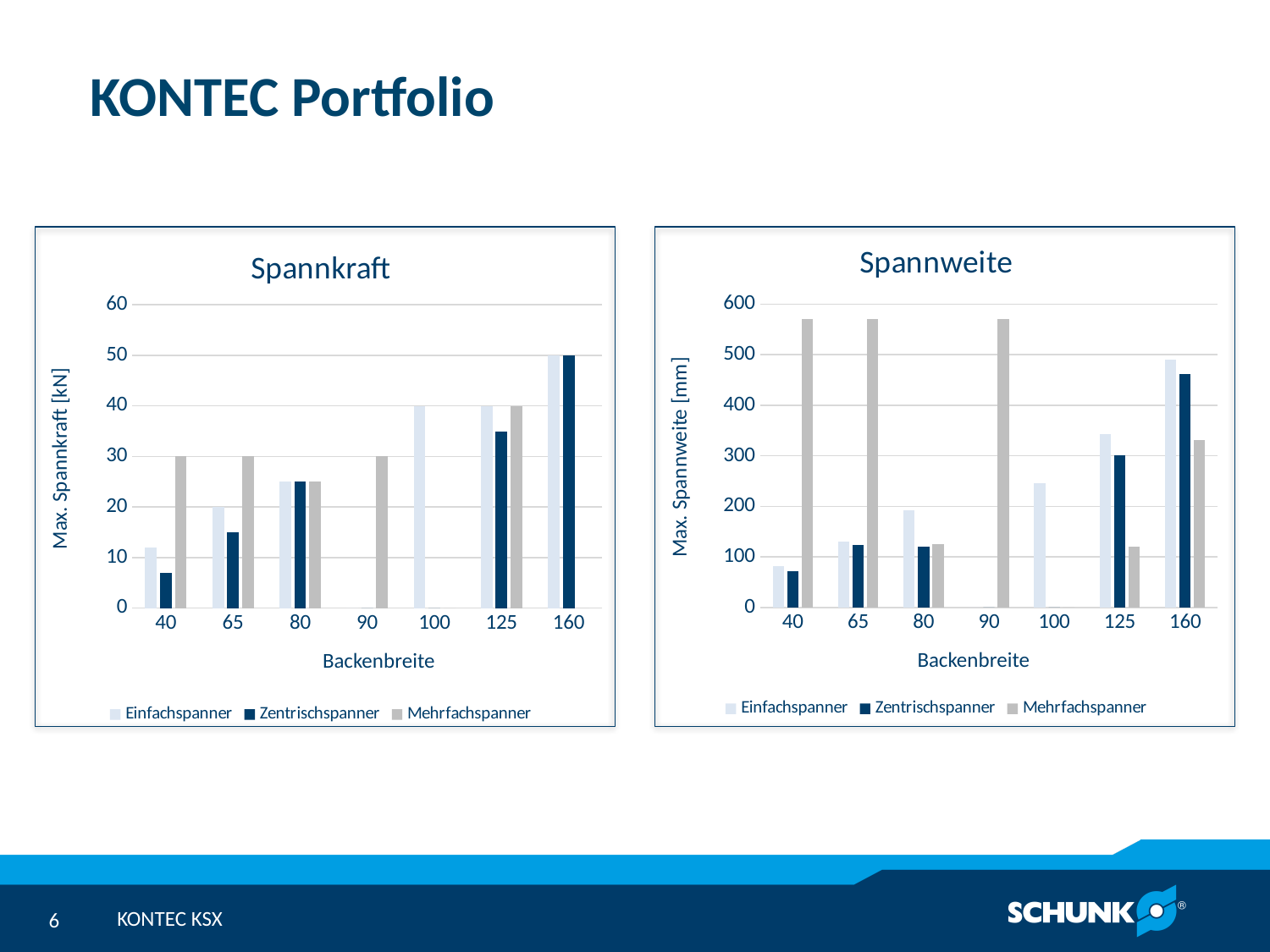
How many Backenbreite categories are shown on the x axis of the Spannkraft chart? 7 In the Spannweite chart, which is larger at Backenbreite 160: Einfachspanner or Mehrfachspanner? Einfachspanner In the Spannkraft chart, what is the value for Einfachspanner at Backenbreite 160? 50 How many series does the legend of the Spannweite chart list? 3 In the Spannweite chart, is the value for Mehrfachspanner at Backenbreite 40 greater or less than 500? greater In the Spannkraft chart, what is the difference between the Einfachspanner values at Backenbreite 160 and Backenbreite 65? 30 In the Spannkraft chart, which Backenbreite has the highest Zentrischspanner value? 160 In the Spannkraft chart, what is the value for Mehrfachspanner at Backenbreite 40? 30 What is the y-axis label of the Spannweite chart? Max. Spannweite [mm] What kind of chart is the Spannkraft chart? bar chart